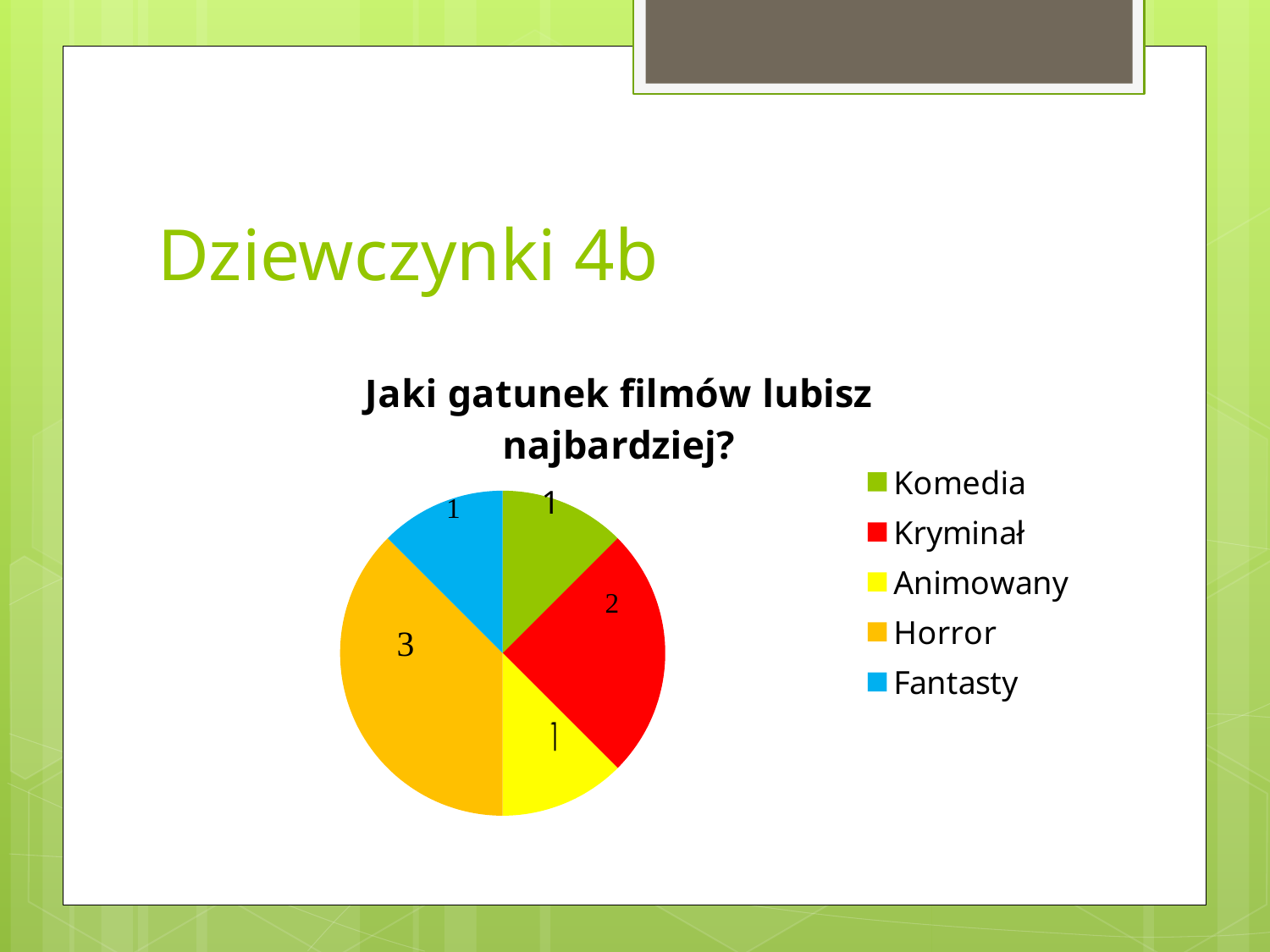
What kind of chart is shown on the slide? pie chart Which category has the largest slice of the pie? Horror What is the value for Horror? 3 What is the value for Kryminał? 2 What is the difference between the values for Horror and Kryminał? 1 How many categories does the pie chart have? 5 Which is larger, the value for Kryminał or the value for Animowany? Kryminał Which colour represents Fantasty in the legend? blue What is the value for Fantasty? 1 What is the total of all the values in the pie chart? 8 What is the value for Komedia? 1 What is the title of the chart? Jaki gatunek filmów lubisz najbardziej?